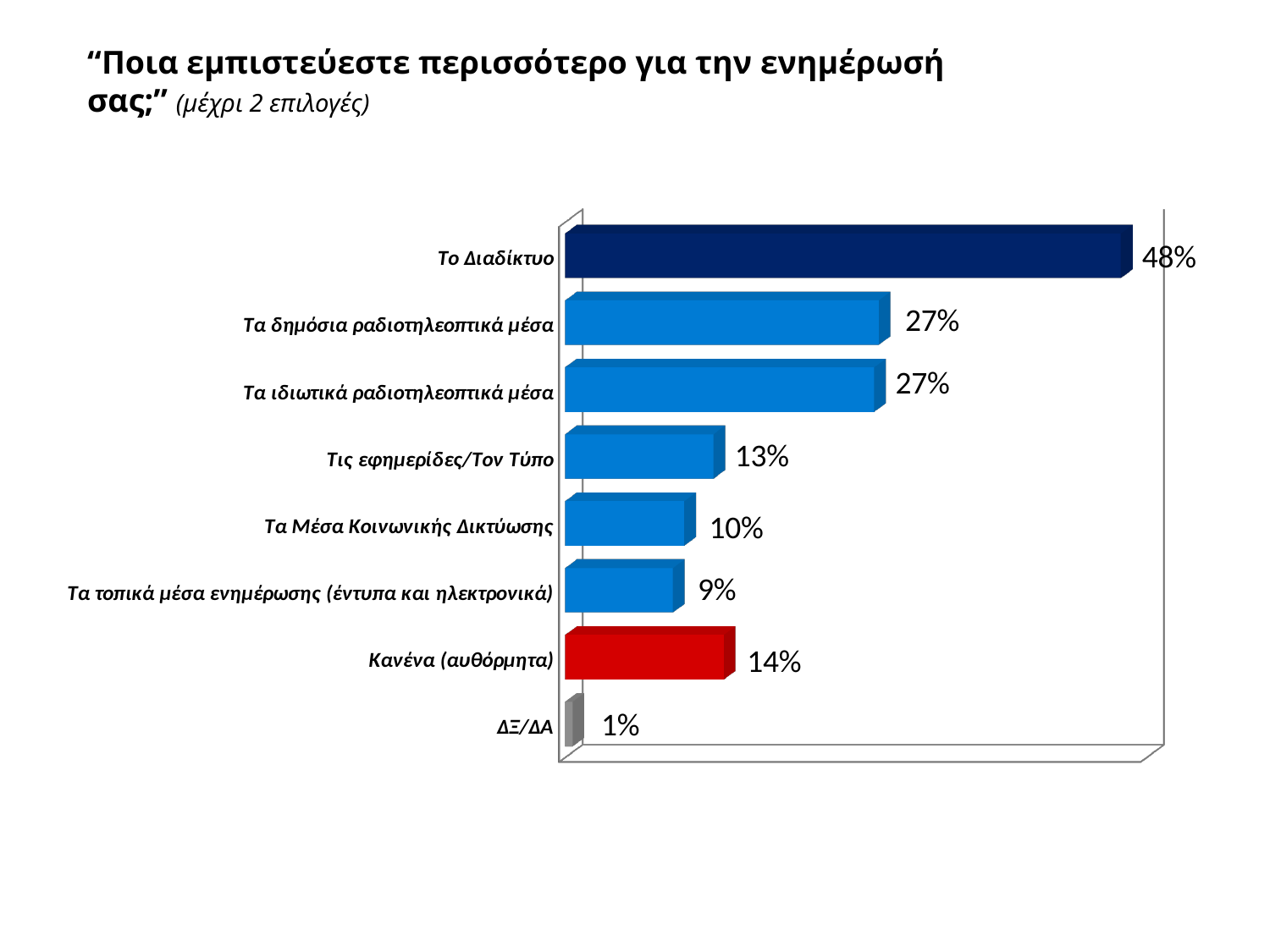
Which category has the highest value? Το Διαδίκτυο What kind of chart is shown on the slide? Bar chart What is the difference between the values for Το Διαδίκτυο and Τα δημόσια ραδιοτηλεοπτικά μέσα? 21% What is the value for Κανένα (αυθόρμητα)? 14% What is the value for Τα τοπικά μέσα ενημέρωσης (έντυπα και ηλεκτρονικά)? 9% What is the value for Τις εφημερίδες/Τον Τύπο? 13% What is the value for Το Διαδίκτυο? 48% Which category has the lowest value? ΔΞ/ΔΑ What colour is the bar for Κανένα (αυθόρμητα)? Red How many categories are shown in the chart? 8 What is the difference between the values for Κανένα (αυθόρμητα) and Τα Μέσα Κοινωνικής Δικτύωσης? 4% Which is larger, the value for Τις εφημερίδες/Τον Τύπο or the value for Τα Μέσα Κοινωνικής Δικτύωσης? Τις εφημερίδες/Τον Τύπο